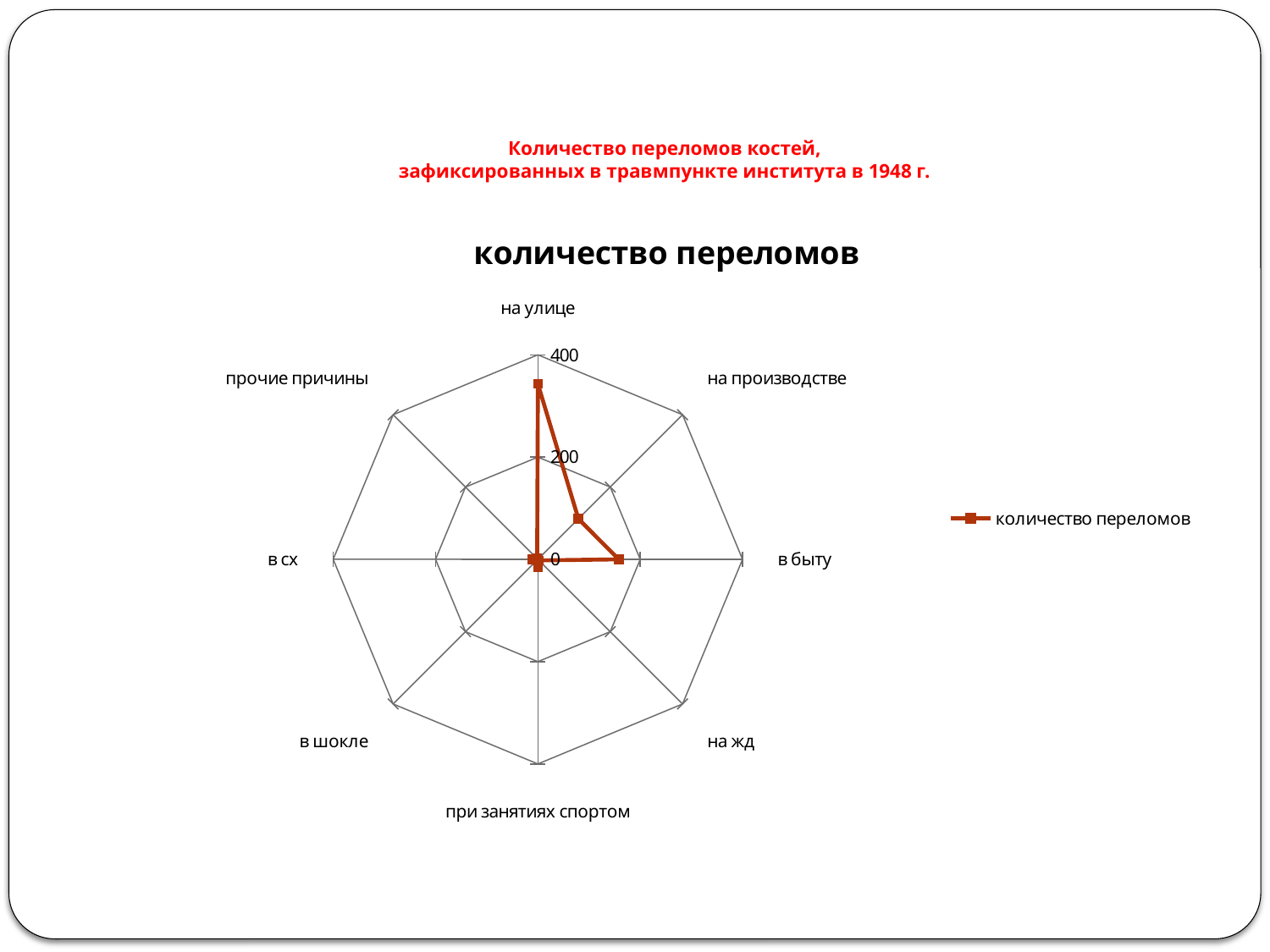
Is the value for 'на улице' greater or less than 200? greater What kind of chart is shown on the slide? radar chart What is the title of the chart? количество переломов Is the value for 'на производстве' greater or less than 200? less Is the value for 'в быту' greater or less than 200? less Which category has the highest number of fractures? на улице Which is larger, the value for 'на улице' or the value for 'в быту'? на улице How many series does the legend list? 1 Which is larger, the value for 'в быту' or the value for 'на производстве'? в быту How many categories are plotted on the radar chart? 8 What is the highest tick value shown on the chart's axis? 400